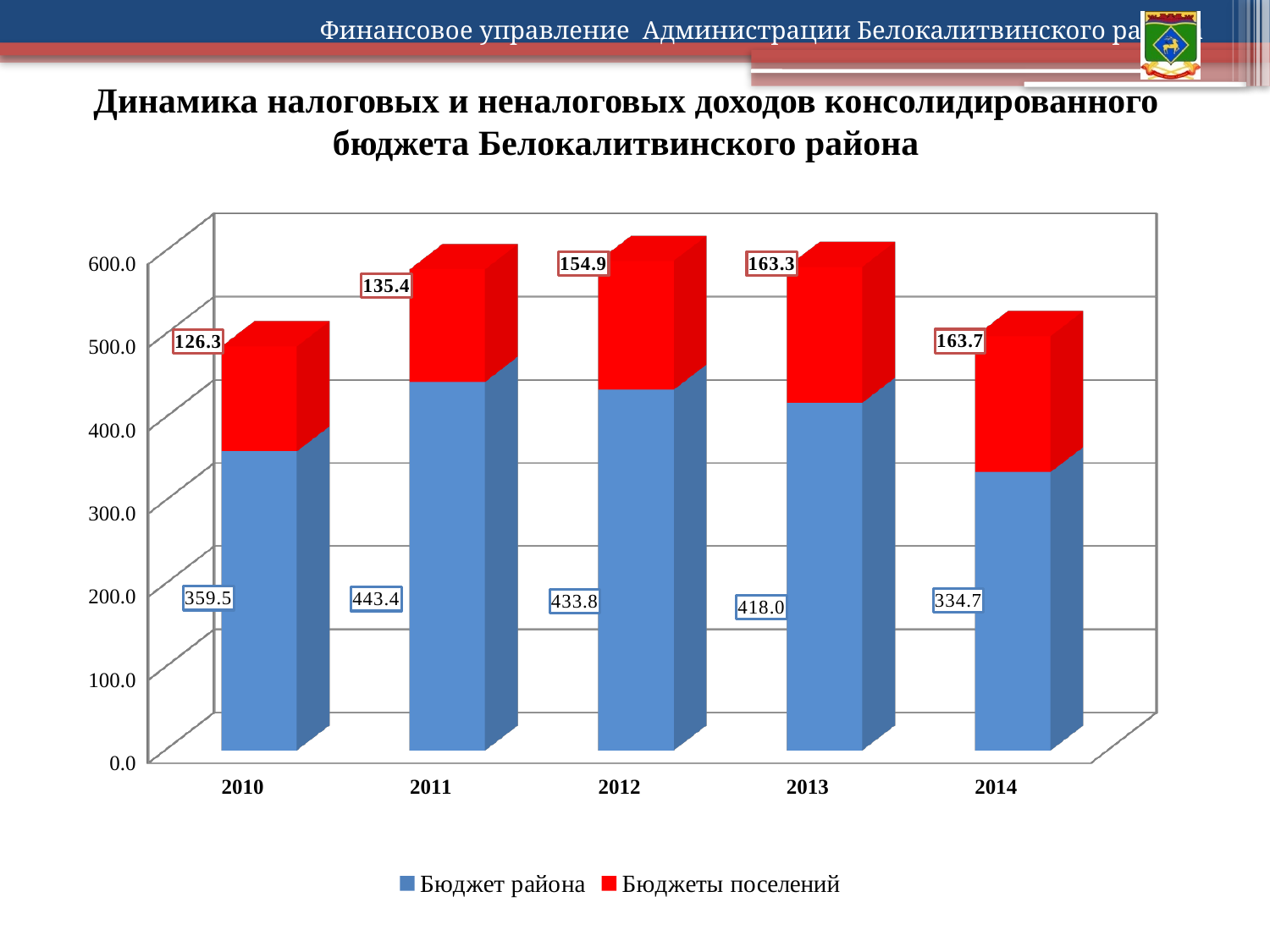
In which year is the value for Бюджет района the highest? 2011 In which year is the value for Бюджеты поселений the lowest? 2010 How many years are shown on the x axis? 5 What is the value for Бюджет района in 2014? 334.7 What is the value for Бюджеты поселений in 2013? 163.3 What is the total of the stacked bar for 2010? 485.8 What is the total of the stacked bar for 2012? 588.7 Which is larger: the Бюджет района value for 2012 or for 2013? 2012 How many series does the legend list? 2 What is the difference between the Бюджет района values for 2011 and 2010? 83.9 Do the values for Бюджеты поселений rise or fall from 2010 to 2014? rise What is the value for Бюджет района in 2011? 443.4